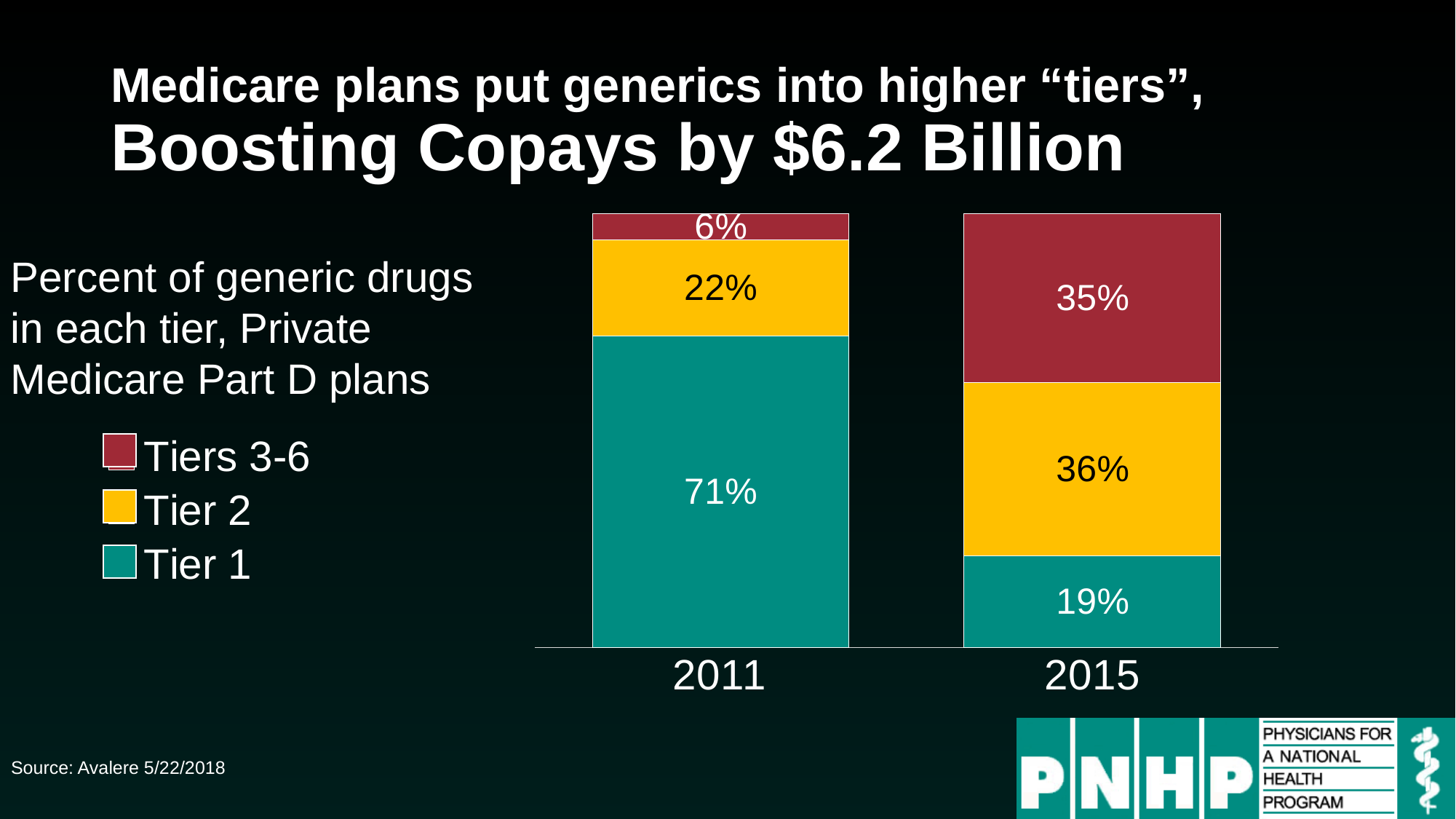
What percent of generic drugs were in Tier 1 in 2011? 71% Which year had the higher share of generic drugs in Tier 1? 2011 Which tier had the smallest share of generic drugs in 2015? Tier 1 By how many percentage points did the Tiers 3-6 share rise from 2011 to 2015? 29 Which colour represents Tier 2 in the chart? Yellow What percent of generic drugs were in Tier 2 in 2015? 36% By how many percentage points did the Tier 1 share fall from 2011 to 2015? 52 What percent of generic drugs were in Tiers 3-6 in 2015? 35% What percent of generic drugs were in Tiers 3-6 in 2011? 6% How many series does the legend list? 3 What kind of chart is shown on the slide? Stacked bar chart Which tier had the smallest share of generic drugs in 2011? Tiers 3-6